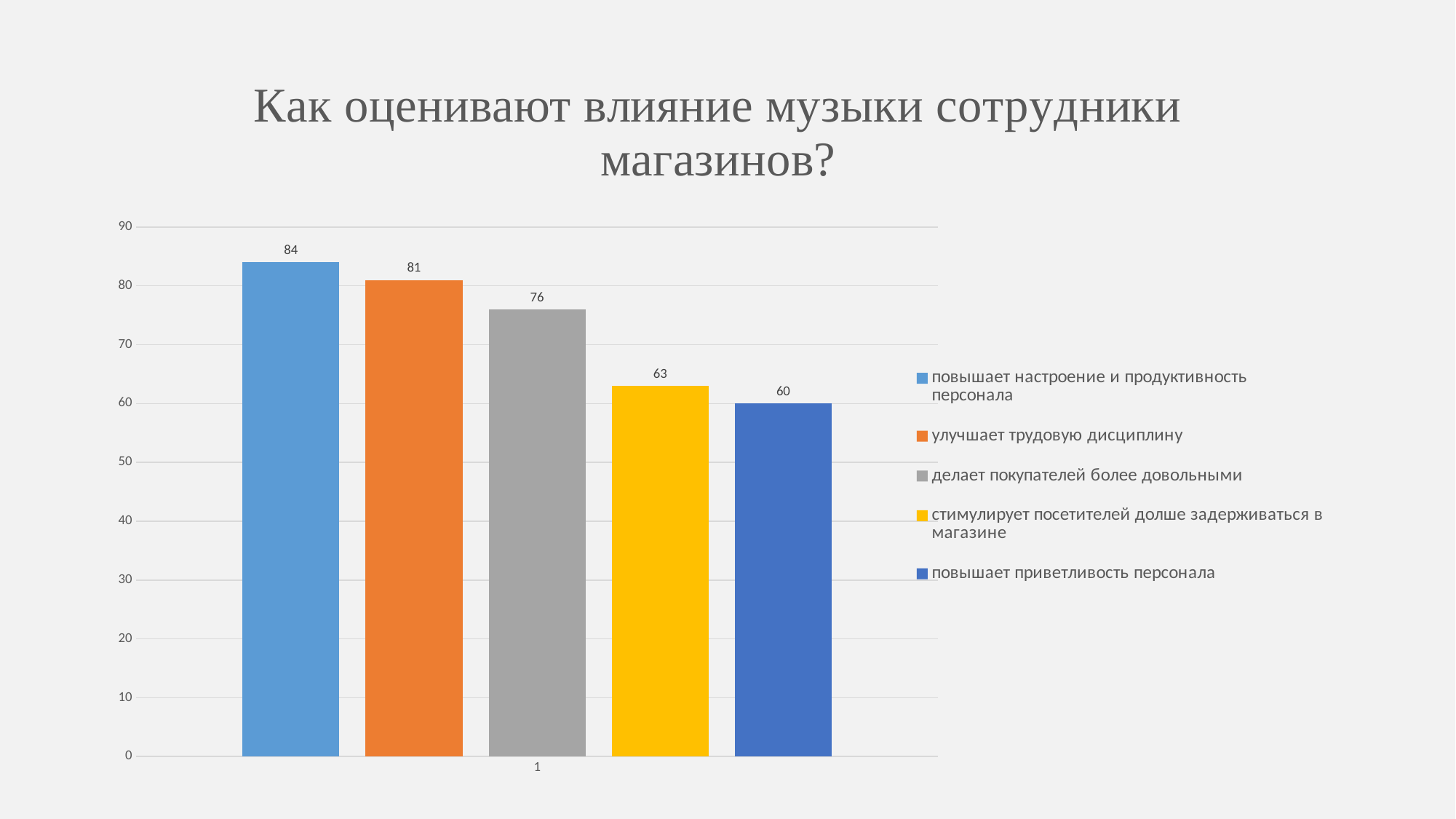
What value is shown for "делает покупателей более довольными"? 76 How many series does the legend list? 5 What value is shown for "стимулирует посетителей дольше задерживаться в магазине"? 63 What value is shown for "повышает приветливость персонала"? 60 What kind of chart is shown on the slide? bar chart What value is shown for "улучшает трудовую дисциплину"? 81 Which series has the lowest value? повышает приветливость персонала What is the difference between the values for "повышает настроение и продуктивность персонала" and "повышает приветливость персонала"? 24 Which series has the highest value? повышает настроение и продуктивность персонала What is the title of the slide? Как оценивают влияние музыки сотрудники магазинов? What value is shown for "повышает настроение и продуктивность персонала"? 84 Which is larger: the value for "делает покупателей более довольными" or the value for "стимулирует посетителей дольше задерживаться в магазине"? делает покупателей более довольными